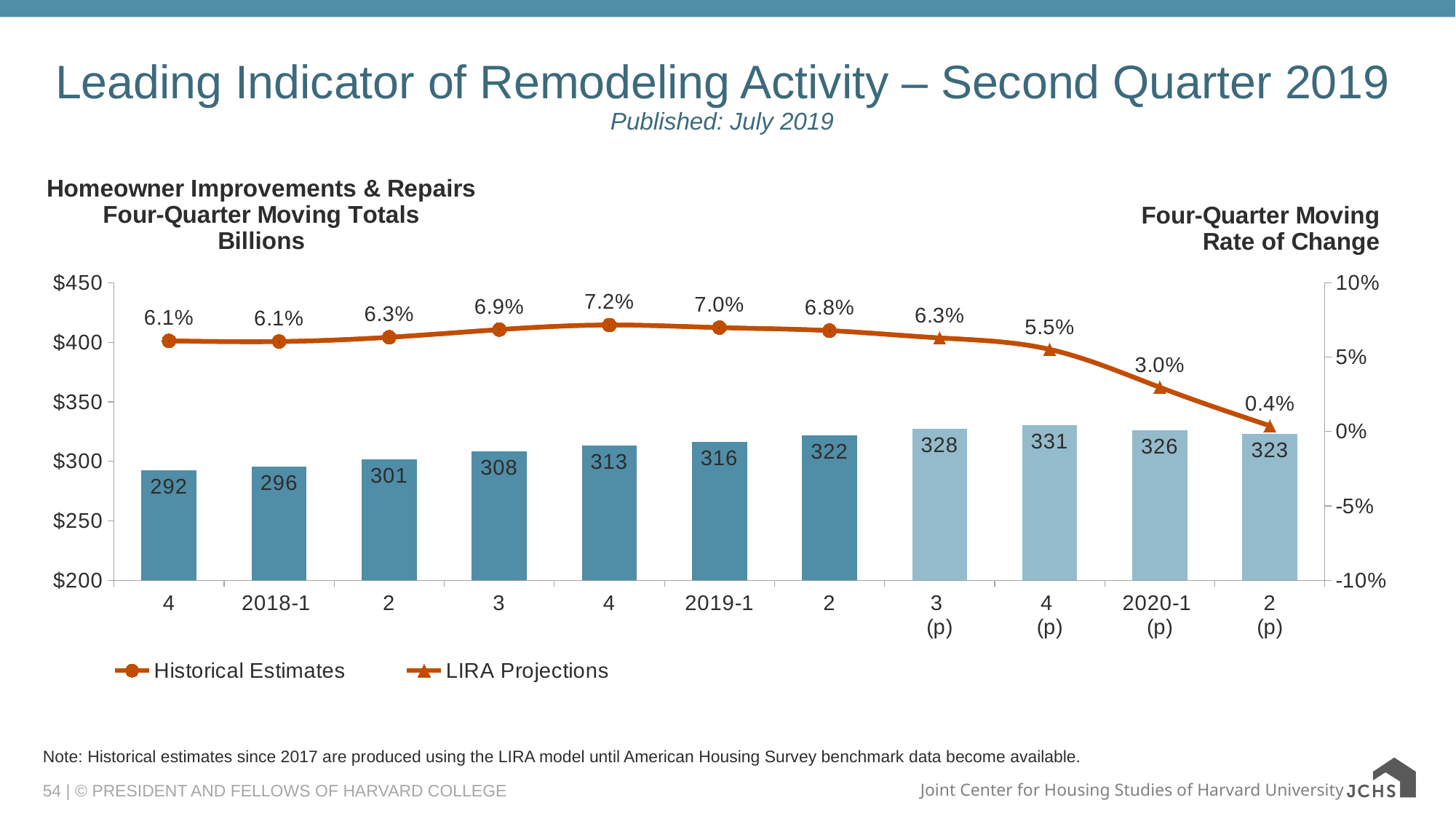
What is the four-quarter moving total for 4 (p)? 331 What are the two legend entries? Historical Estimates and LIRA Projections Which is larger, the rate of change for 2019-1 or for 3 (p)? 2019-1 How many periods are shown on the x axis? 11 What is the four-quarter moving total for 2019-1? 316 Which period has the lowest four-quarter moving total? 4 (2017) Is the four-quarter moving total for 2 (2019) greater or less than $300? greater How many entries does the legend list? 2 Which period has the highest four-quarter moving rate of change? 4 (2018) What is the trend of the rate of change line from 4 (2018) to 2 (p)? falling What is the four-quarter moving rate of change for 2020-1 (p)? 3.0% What is the difference between the four-quarter moving totals for 2 (p) and 2018-1? 27